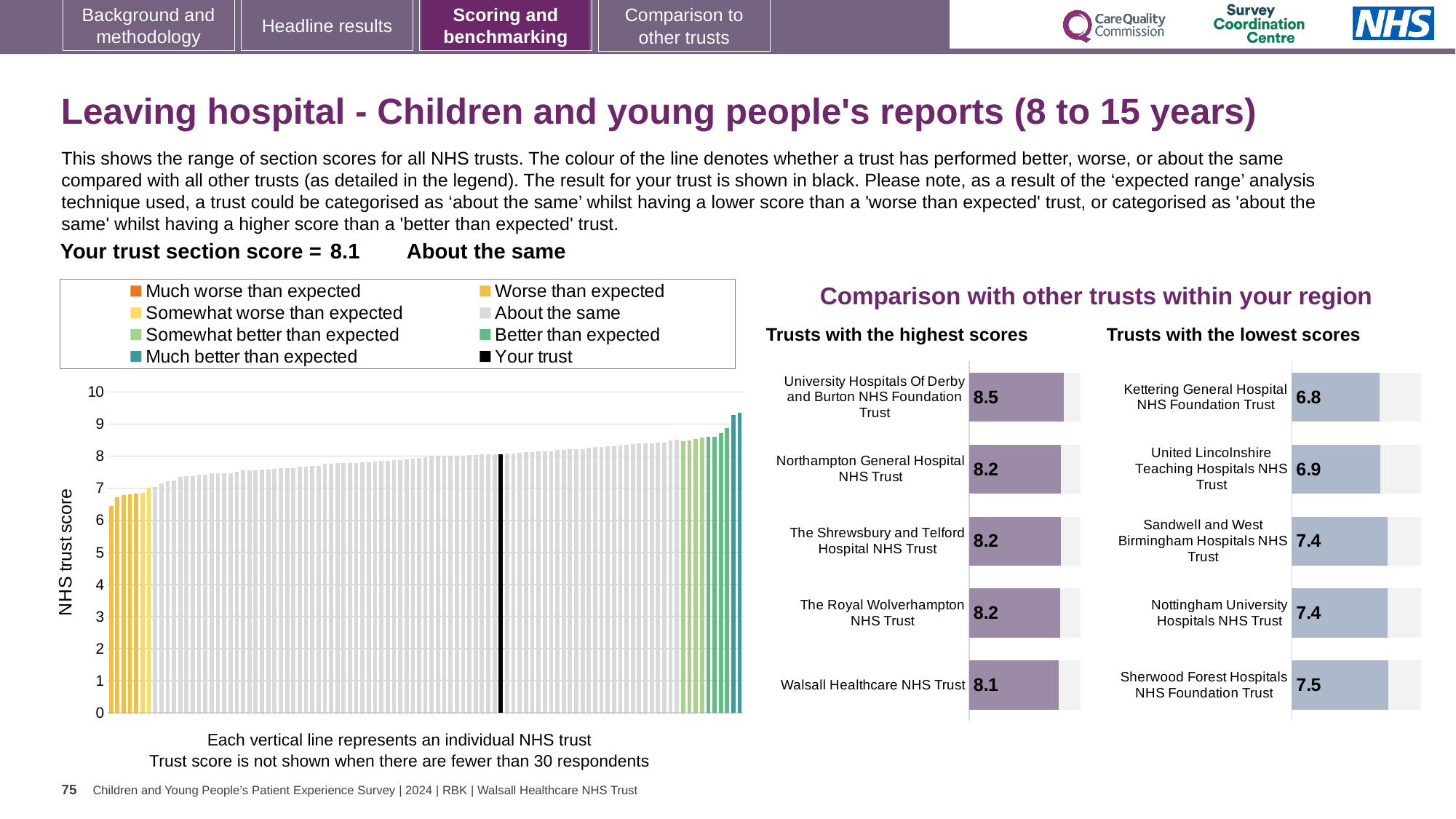
How many trusts are listed in the 'Trusts with the highest scores' chart? 5 In the 'Trusts with the highest scores' chart, what is the score for University Hospitals Of Derby and Burton NHS Foundation Trust? 8.5 In the 'Trusts with the lowest scores' chart, which trust has the lowest score? Kettering General Hospital NHS Foundation Trust In the 'Trusts with the lowest scores' chart, what is the difference between the scores of Sherwood Forest Hospitals NHS Foundation Trust and Kettering General Hospital NHS Foundation Trust? 0.7 In the main NHS trust score chart on the left, is the value of the lowest bar greater or less than 7? less In the 'Trusts with the lowest scores' chart, what is the score for Kettering General Hospital NHS Foundation Trust? 6.8 In the 'Trusts with the lowest scores' chart, what is the score for Sherwood Forest Hospitals NHS Foundation Trust? 7.5 How many entries does the legend of the main NHS trust score chart list? 8 In the 'Trusts with the lowest scores' chart, which has the higher score: United Lincolnshire Teaching Hospitals NHS Trust or Sandwell and West Birmingham Hospitals NHS Trust? Sandwell and West Birmingham Hospitals NHS Trust In the 'Trusts with the highest scores' chart, what is the difference between the scores of University Hospitals Of Derby and Burton NHS Foundation Trust and Walsall Healthcare NHS Trust? 0.4 What kind of chart is the main NHS trust score chart on the left? bar chart In the 'Trusts with the highest scores' chart, which trust has the lowest score? Walsall Healthcare NHS Trust